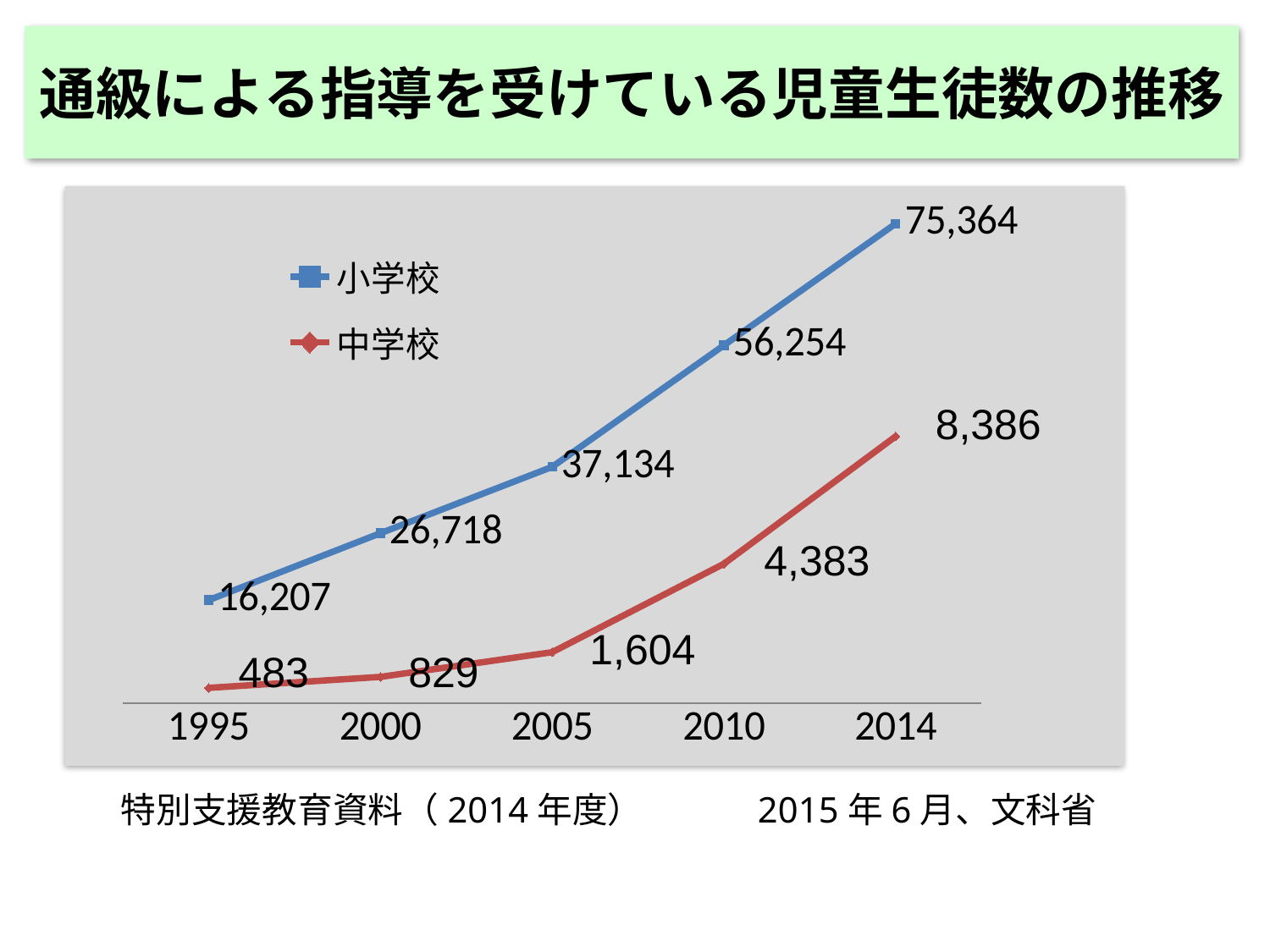
What is the value for 中学校 in 1995? 483 How many series does the legend list? 2 What is the difference between the 中学校 values in 2014 and 2010? 4,003 Which is larger in 2000, the value for 小学校 or for 中学校? 小学校 What is the value for 小学校 in 2005? 37,134 What is the value for 中学校 in 2010? 4,383 In which year is the value for 小学校 highest? 2014 In which year is the value for 中学校 lowest? 1995 What is the difference between the 小学校 values in 2014 and 2010? 19,110 What is the value for 小学校 in 2014? 75,364 What kind of chart is shown on the slide? line chart How many years are plotted on the x axis? 5